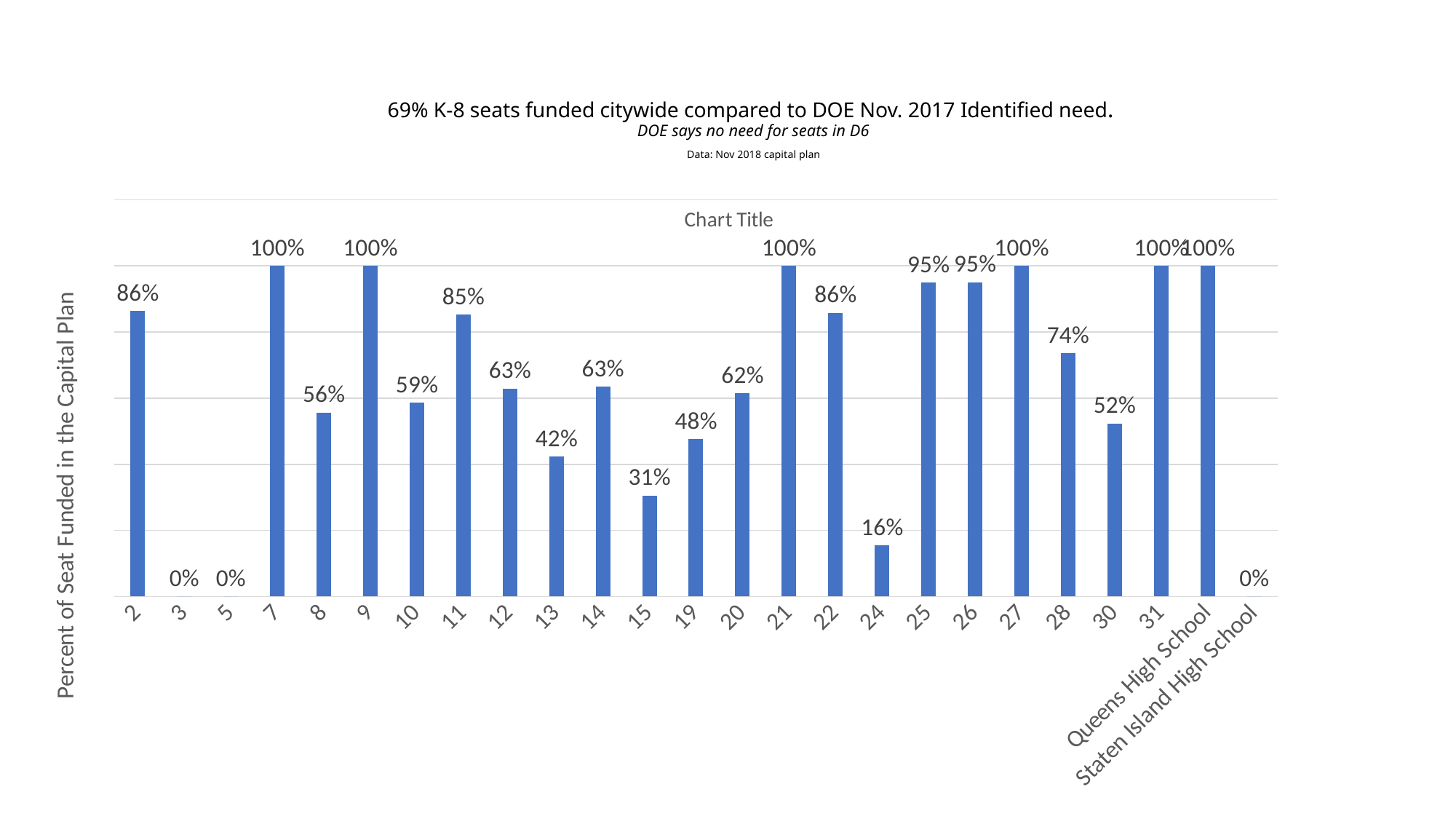
How many categories are shown on the x axis? 25 What is the value for Staten Island High School? 0% What is the label on the vertical axis of the chart? Percent of Seat Funded in the Capital Plan What is the value for district 2? 86% What is the value for district 24? 16% What kind of chart is shown on the slide? bar chart Among the categories with a non-zero value, which has the lowest value? 24 What is the value for district 15? 31% What is the value for Queens High School? 100% What is the difference between the values for district 28 and district 30? 22% Which is larger, the value for district 8 or the value for district 10? district 10 What is the difference between the values for district 11 and district 13? 43%